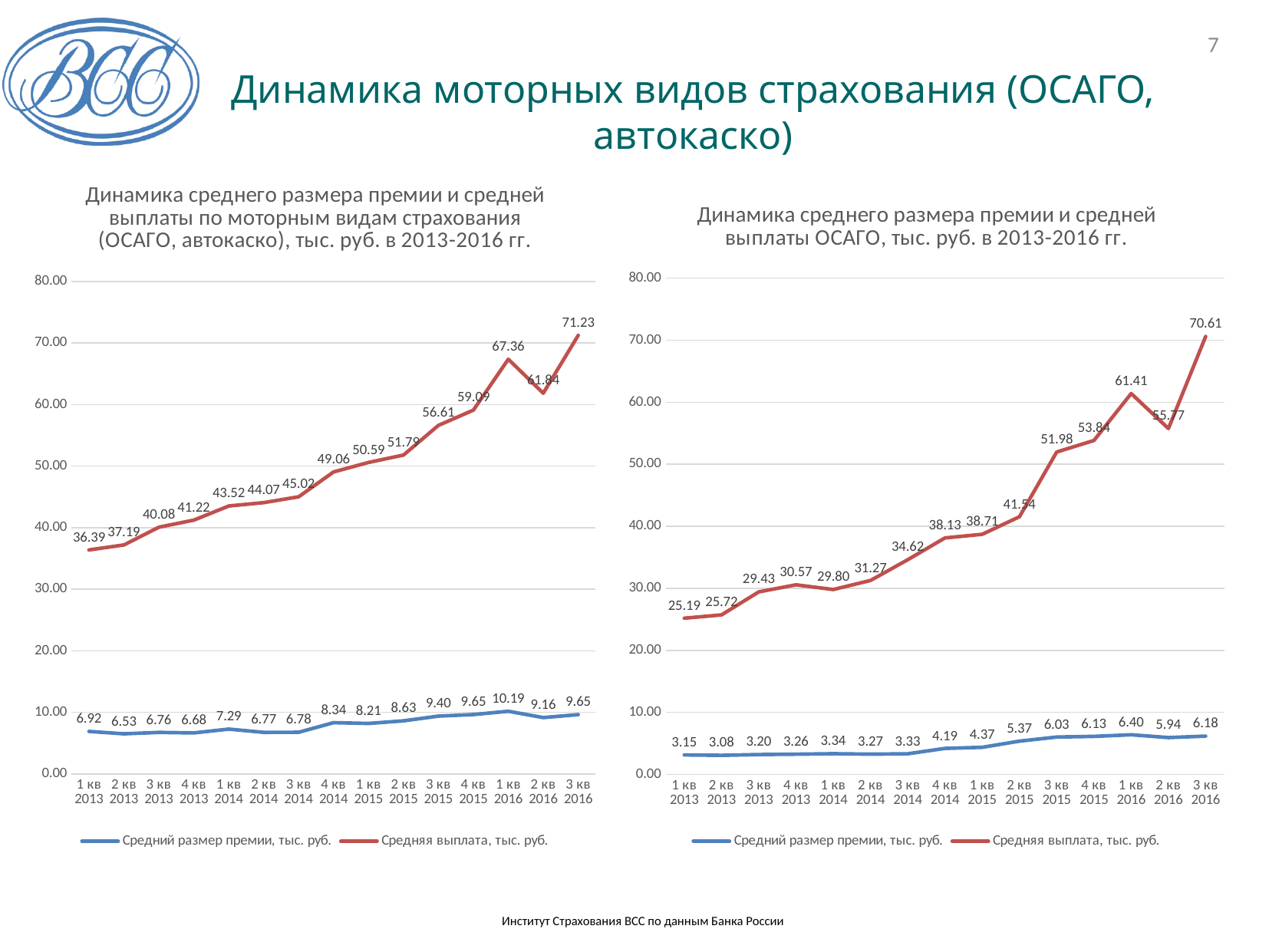
How many quarters are plotted along the x axis of the left chart? 15 In the left chart (motor insurance, ОСАГО and автокаско), what is the difference between the average payout in 1 кв 2016 and in 2 кв 2016? 5.52 In the right chart (ОСАГО), in which quarter is the average payout highest? 3 кв 2016 In the right chart (ОСАГО), which is larger: the average payout in 1 кв 2016 or in 2 кв 2016? 1 кв 2016 In the left chart (motor insurance, ОСАГО and автокаско), what is the average payout (Средняя выплата) in 3 кв 2016? 71.23 What type of chart is used on the left side of the slide? Line chart In the right chart (ОСАГО), in which quarter is the average premium lowest? 2 кв 2013 In the left chart, which colour is used for the average payout (Средняя выплата) line? Red In the right chart (ОСАГО), does the average payout generally rise or fall from 1 кв 2013 to 3 кв 2016? Rise In the left chart (motor insurance, ОСАГО and автокаско), what is the average premium (Средний размер премии) in 1 кв 2016? 10.19 How many series does the legend of the right chart list? 2 In the right chart (ОСАГО), what is the average payout in 1 кв 2013? 25.19